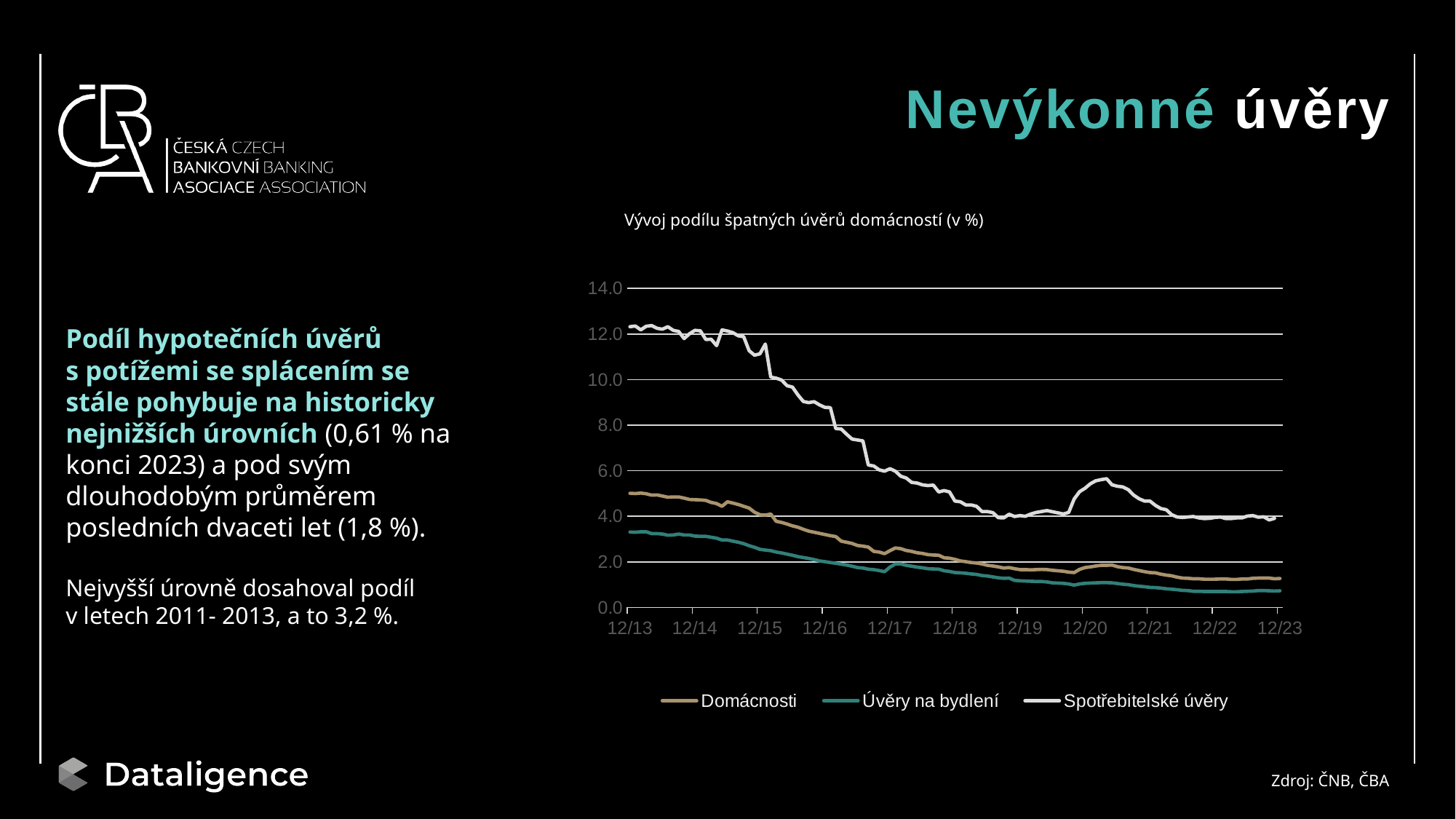
Is the value for Domácnosti at 12/13 greater or less than 4.0? greater Does the Spotřebitelské úvěry line rise or fall overall from 12/13 to 12/23? fall At 12/23, which is larger: Domácnosti or Úvěry na bydlení? Domácnosti Which series has the lowest values at 12/23? Úvěry na bydlení How many series does the chart legend list? 3 What is the title of the chart? Vývoj podílu špatných úvěrů domácností (v %) How many date labels are shown on the x axis? 11 What kind of chart is shown on the slide? line chart Which series has the highest values across the whole period? Spotřebitelské úvěry Is the value for Úvěry na bydlení at 12/23 greater or less than 2.0? less Which series is plotted with the white line? Spotřebitelské úvěry Is the value for Spotřebitelské úvěry at 12/13 greater or less than 10.0? greater